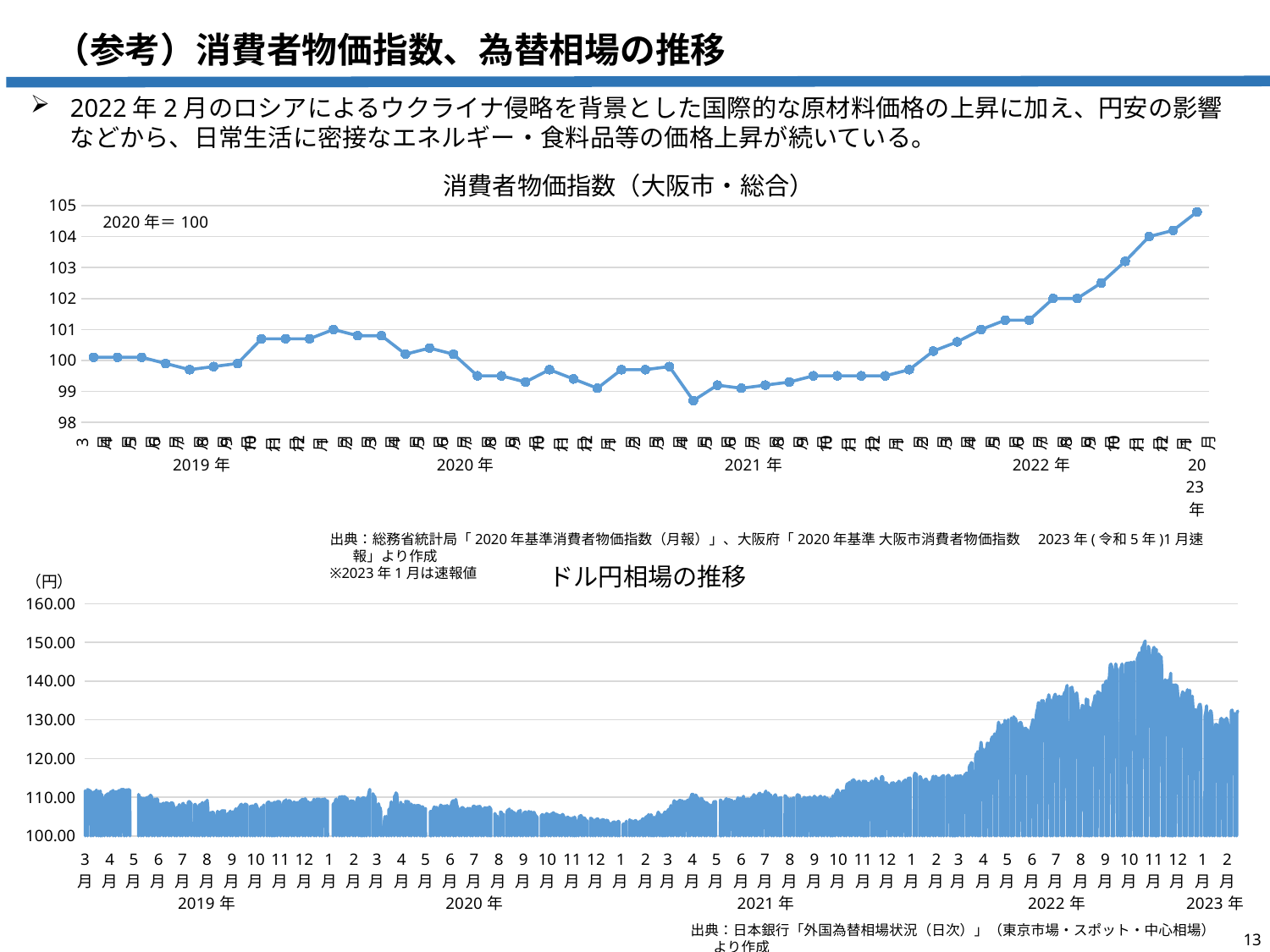
In the bottom chart ドル円相場の推移, which is larger, the value around 2022年10月 or the value around 2019年3月? 2022年10月 What unit is shown on the y axis of the bottom chart ドル円相場の推移? 円 In the top chart 消費者物価指数（大阪市・総合）, do the values rise or fall from 2021年 to 2023年1月? rise What kind of chart is the top chart titled 消費者物価指数（大阪市・総合）? line chart In the top chart 消費者物価指数（大阪市・総合）, which base year is set to 100? 2020年 What kind of chart is the bottom chart titled ドル円相場の推移? bar chart In the top chart 消費者物価指数（大阪市・総合）, which month has the highest value? 2023年1月 In the bottom chart ドル円相場の推移, is the value around 2022年10月 greater or less than 140.00? greater In the top chart 消費者物価指数（大阪市・総合）, is the value for 2023年1月 greater or less than 104? greater In the top chart 消費者物価指数（大阪市・総合）, is the value for 2021年4月 greater or less than 99? less In the bottom chart ドル円相場の推移, do the values rise or fall from 2021年 to 2022年10月? rise